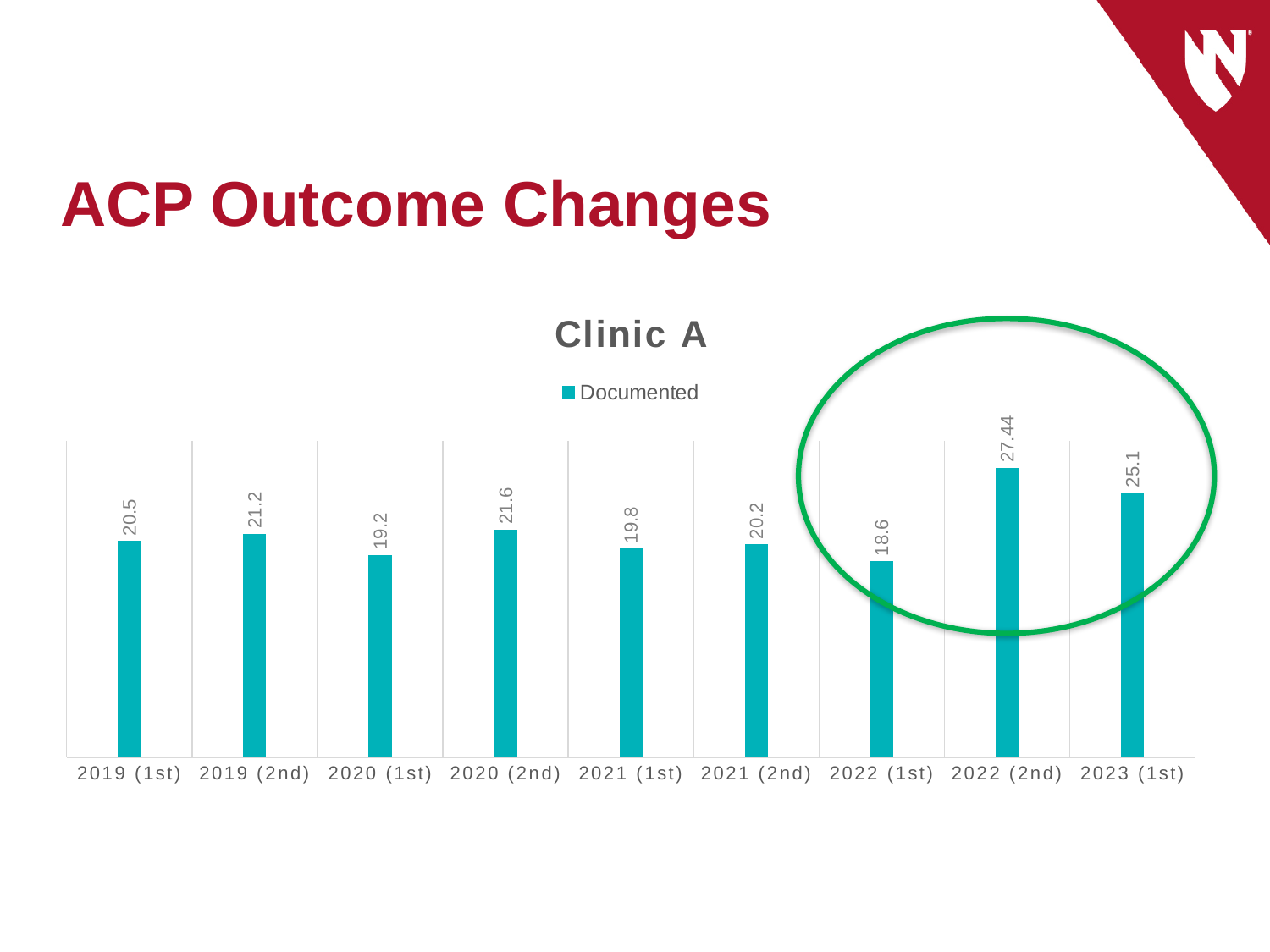
What kind of chart is shown? Bar chart What is the difference between the Documented values for 2022 (2nd) and 2022 (1st)? 8.84 What is the Documented value for 2022 (2nd)? 27.44 How many series does the legend list? 1 What is the title of the chart? Clinic A What is the Documented value for 2019 (1st)? 20.5 Which period has the lowest Documented value? 2022 (1st) Which period has the highest Documented value? 2022 (2nd) Which is larger, the Documented value for 2019 (2nd) or for 2021 (1st)? 2019 (2nd) What is the difference between the Documented values for 2020 (2nd) and 2020 (1st)? 2.4 What is the Documented value for 2023 (1st)? 25.1 How many periods are shown on the x axis? 9